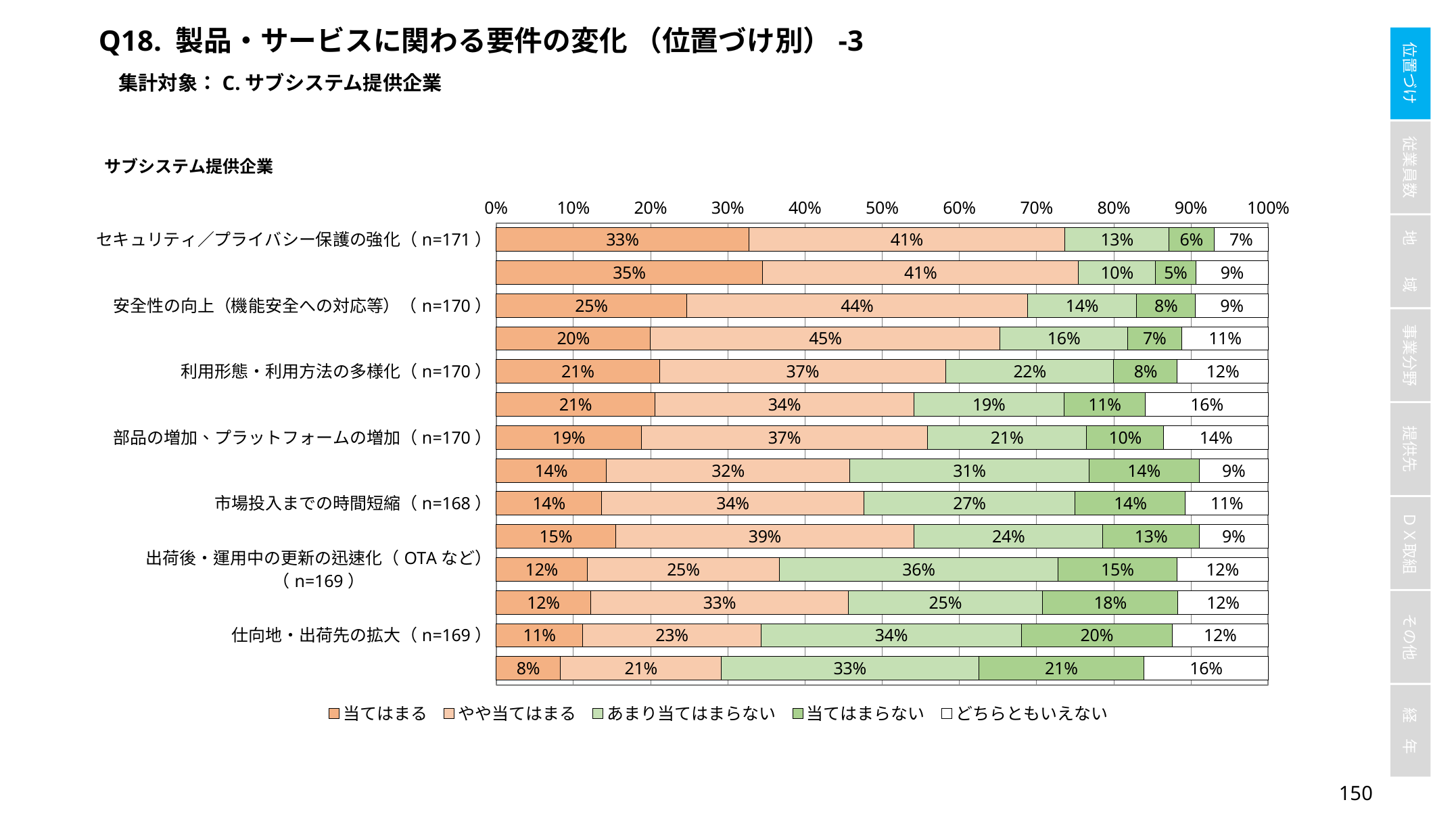
What is the 当てはまらない value for 出荷後・運用中の更新の迅速化（OTAなど）? 15% What percentage of respondents answered 当てはまる for セキュリティ／プライバシー保護の強化? 33% Among the labeled categories, which has the highest 当てはまる value? セキュリティ／プライバシー保護の強化 What is the どちらともいえない value for 部品の増加、プラットフォームの増加? 14% What is the difference between the 当てはまる values for セキュリティ／プライバシー保護の強化 and 市場投入までの時間短縮? 19 percentage points What type of chart is shown on the slide? Stacked horizontal bar chart What is the あまり当てはまらない value for 仕向地・出荷先の拡大? 34% Which is larger: the あまり当てはまらない value for 利用形態・利用方法の多様化 or for 市場投入までの時間短縮? 市場投入までの時間短縮 What is the combined share of 当てはまる and やや当てはまる for 安全性の向上（機能安全への対応等）? 69% How many series does the legend list? 5 Among the labeled categories, which has the lowest 当てはまる value? 仕向地・出荷先の拡大 What is the やや当てはまる value for 安全性の向上（機能安全への対応等）? 44%